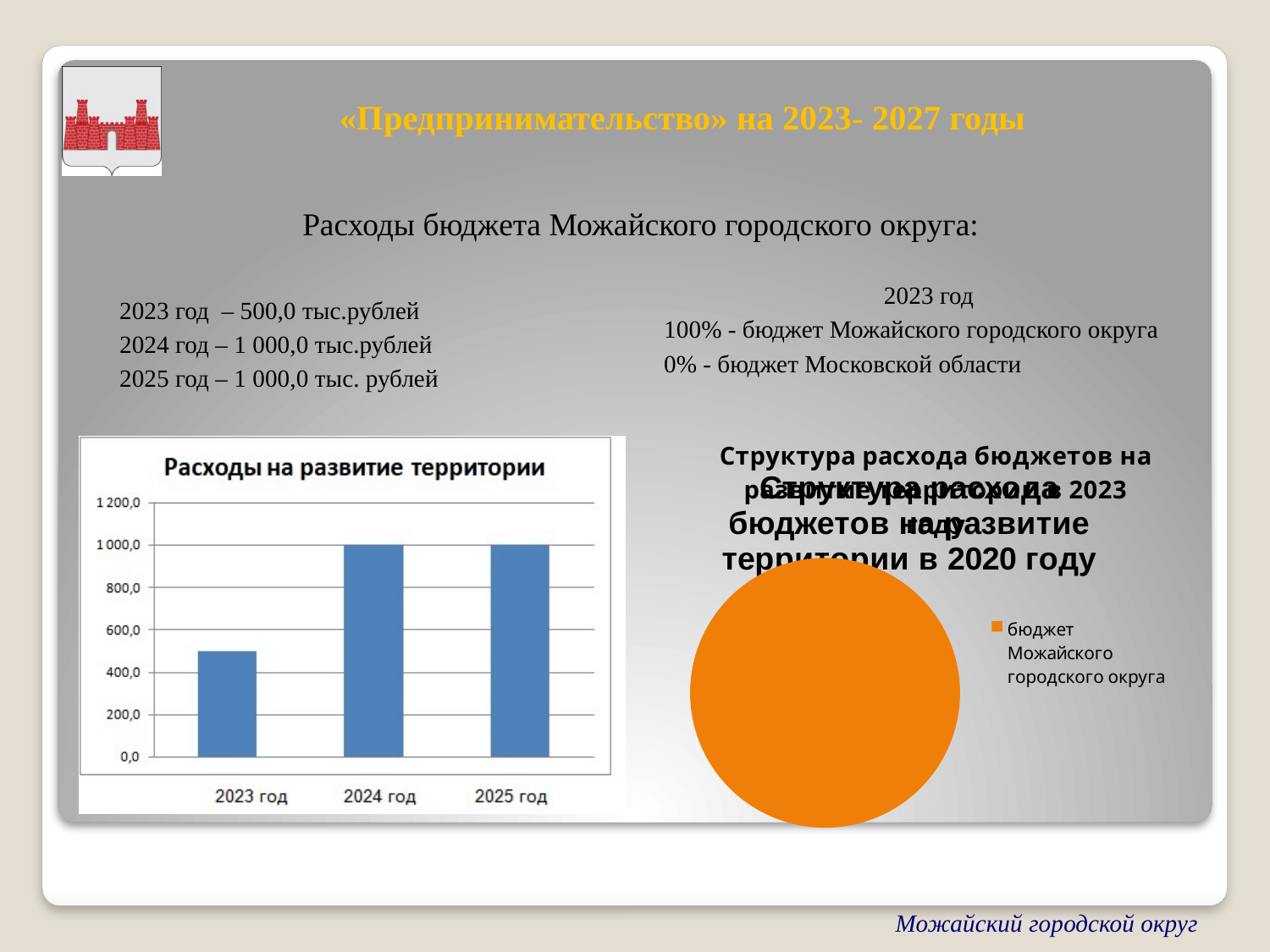
In the chart «Расходы на развитие территории», is the value for 2023 год greater or less than 600,0? less In the chart «Расходы на развитие территории», which is larger, the value for 2023 год or the value for 2024 год? 2024 год What kind of chart is the chart titled «Расходы на развитие территории»? bar chart In the chart «Расходы на развитие территории», do the values rise or fall from 2023 год to 2024 год? rise In the chart «Расходы на развитие территории», is the value for 2023 год greater or less than 400,0? greater In the chart «Расходы на развитие территории», which category has the lowest value? 2023 год What kind of chart is the chart on the right side of the slide? pie chart In the chart «Расходы на развитие территории», how many categories are shown on the x axis? 3 In the chart «Расходы на развитие территории», what is the value for 2024 год? 1 000,0 In the pie chart on the right side of the slide, how many entries does the legend list? 1 In the pie chart on the right side of the slide, what is the legend entry for the orange slice? бюджет Можайского городского округа In the chart «Расходы на развитие территории», what is the value for 2025 год? 1 000,0